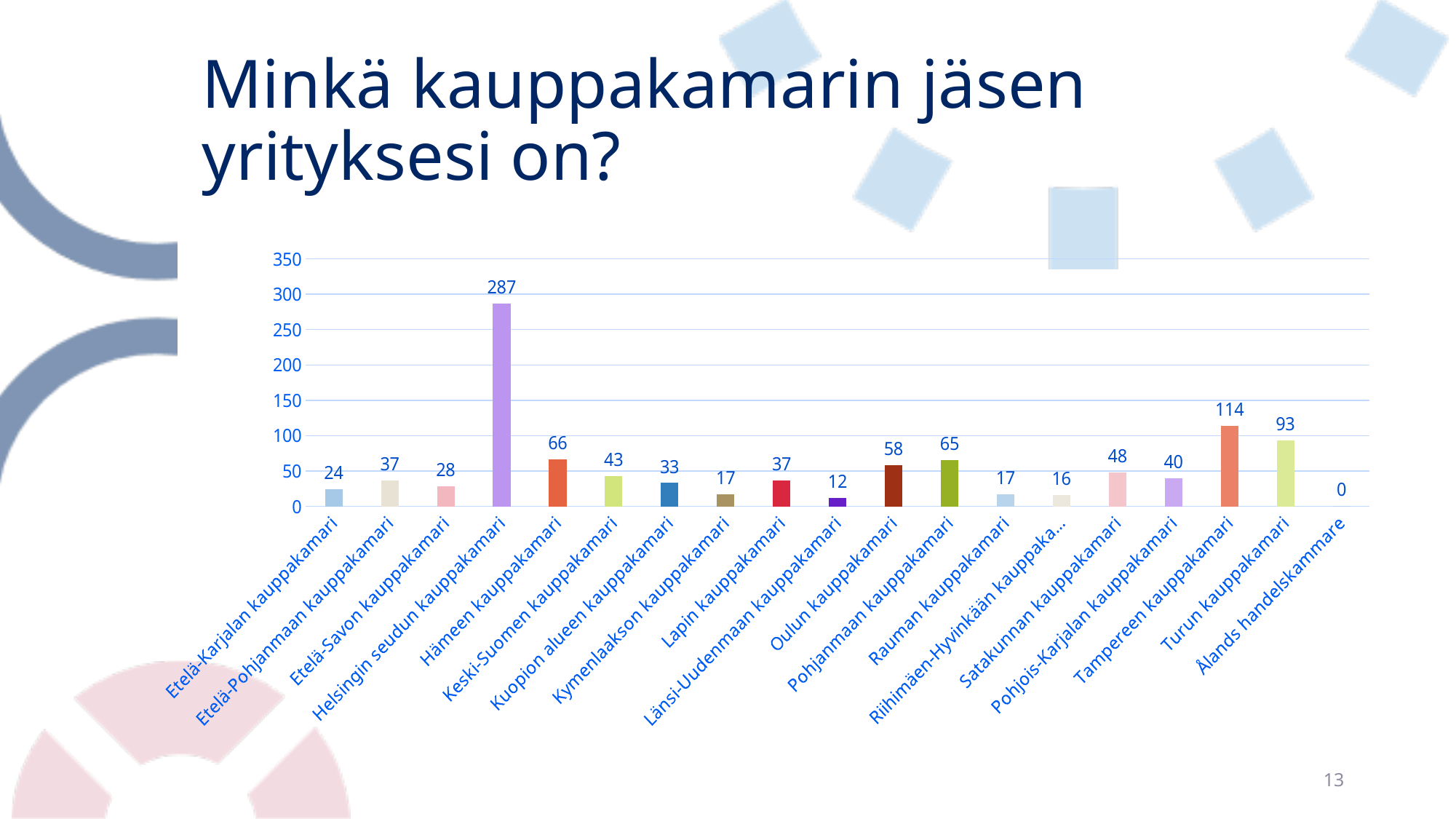
Which is larger, the value for Oulun kauppakamari or Pohjanmaan kauppakamari? Pohjanmaan kauppakamari What is the value for Tampereen kauppakamari? 114 Which chamber of commerce has the lowest value? Ålands handelskammare What is the value for Ålands handelskammare? 0 What is the value for Länsi-Uudenmaan kauppakamari? 12 Which chamber of commerce has the highest value? Helsingin seudun kauppakamari What is the difference between the values for Tampereen kauppakamari and Turun kauppakamari? 21 Is the value for Hämeen kauppakamari greater or less than 50? greater What is the value for Helsingin seudun kauppakamari? 287 What is the title of the slide containing the chart? Minkä kauppakamarin jäsen yrityksesi on? What kind of chart is shown on the slide? bar chart How many categories are shown on the x axis? 19